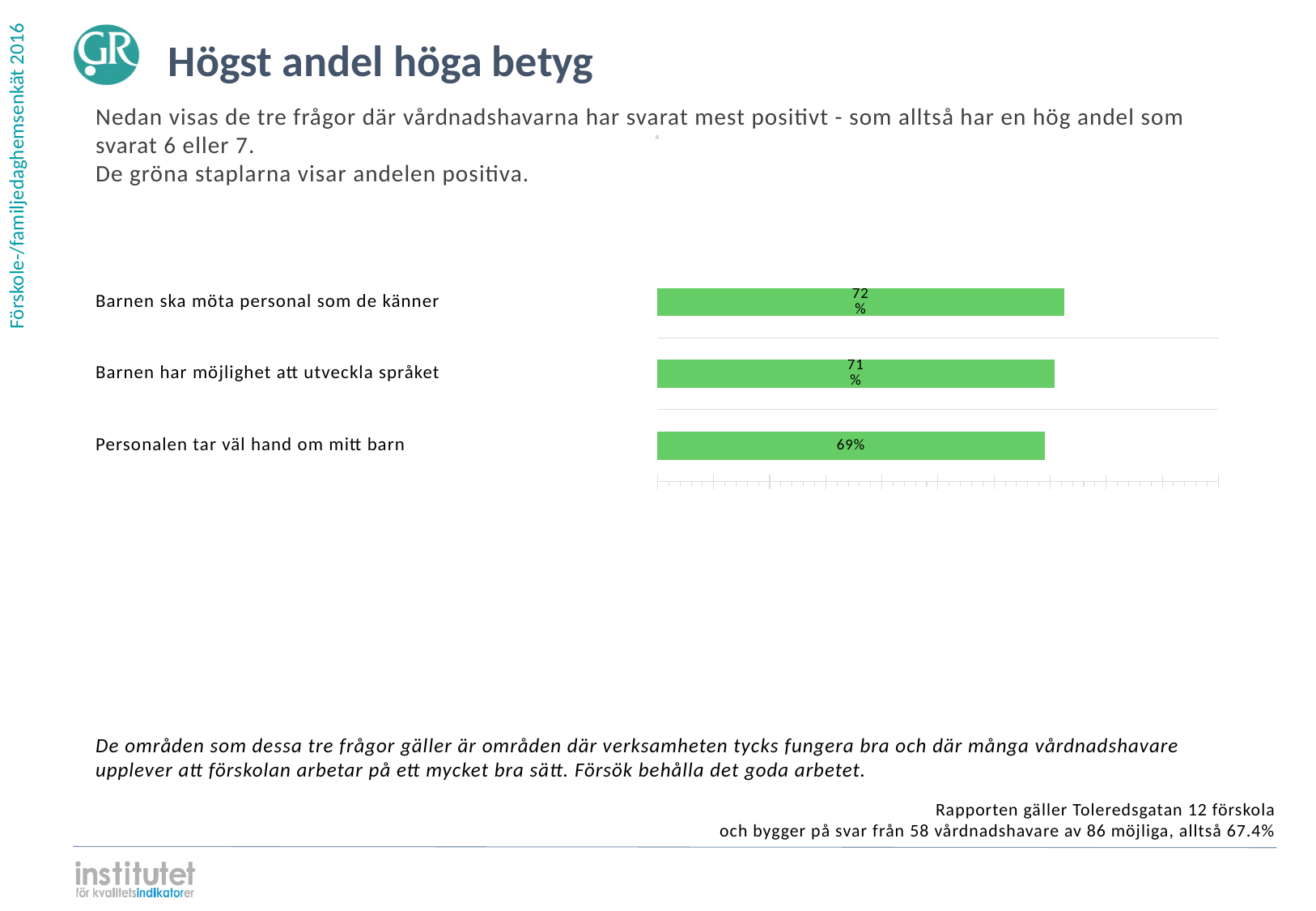
Which is larger: the value for "Barnen ska möta personal som de känner" or the value for "Barnen har möjlighet att utveckla språket"? Barnen ska möta personal som de känner What colour are the bars in the chart? Green What is the value for "Barnen ska möta personal som de känner"? 72% How many categories are shown in the chart? 3 What is the difference between the values for "Barnen har möjlighet att utveckla språket" and "Personalen tar väl hand om mitt barn"? 2% What is the value for "Personalen tar väl hand om mitt barn"? 69% Which category has the lowest value? Personalen tar väl hand om mitt barn Which category has the highest value? Barnen ska möta personal som de känner What is the value for "Barnen har möjlighet att utveckla språket"? 71% What is the title of the slide containing the chart? Högst andel höga betyg What is the difference between the values for "Barnen ska möta personal som de känner" and "Personalen tar väl hand om mitt barn"? 3% What kind of chart is shown on the slide? Bar chart